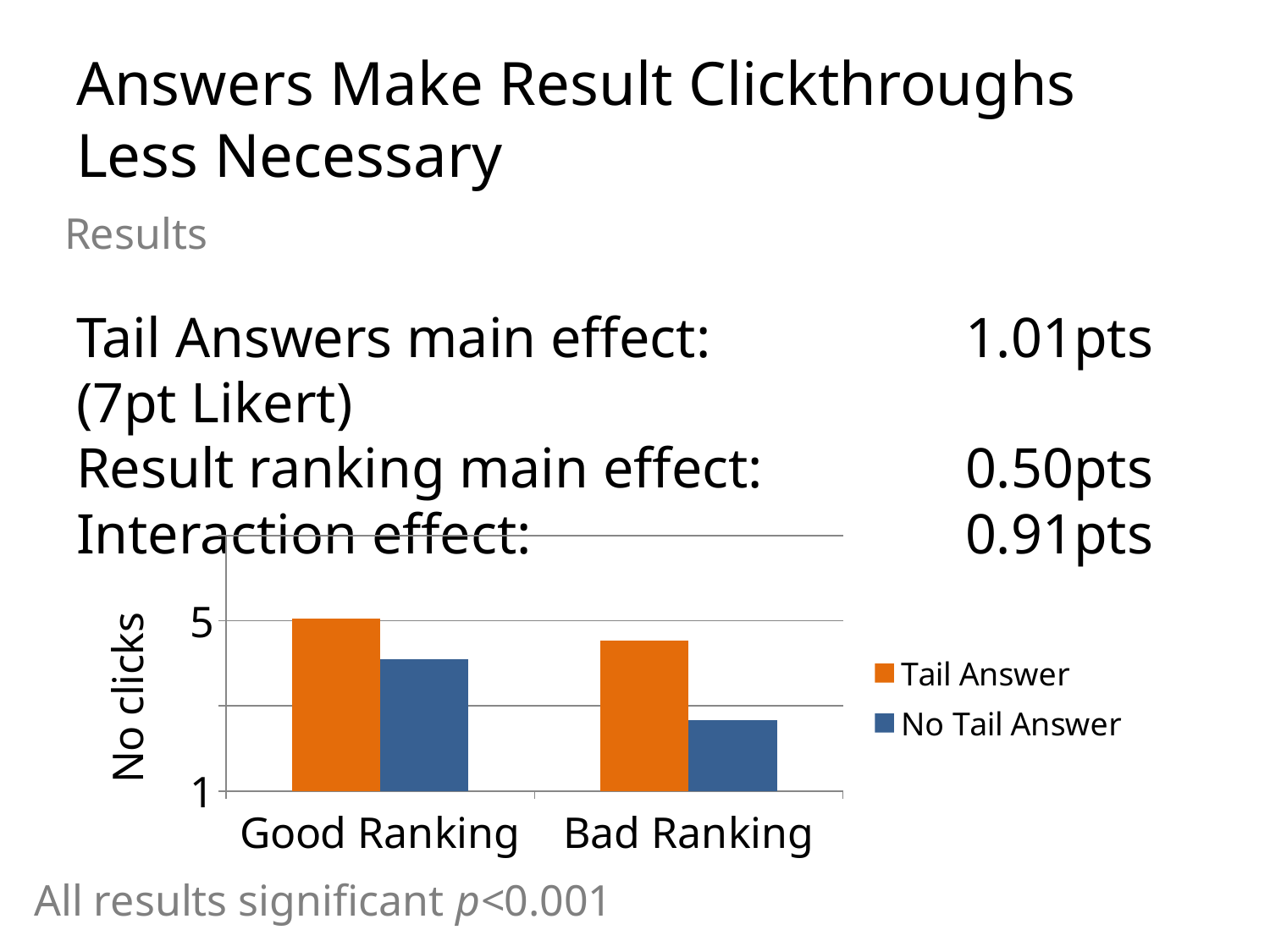
Is the value for Tail Answer under Bad Ranking greater or less than 5? less What kind of chart is shown on the slide? bar chart Is the value for No Tail Answer under Bad Ranking greater or less than 5? less Does the Tail Answer series rise or fall from Good Ranking to Bad Ranking? fall Which series has the taller bar for Bad Ranking, Tail Answer or No Tail Answer? Tail Answer What is the label on the chart's y axis? No clicks How many series does the chart's legend list? 2 What colour represents the Tail Answer series in the chart? orange Which bar in the chart is the highest? Tail Answer for Good Ranking How many categories are shown on the x axis of the chart? 2 Which series has the taller bar for Good Ranking, Tail Answer or No Tail Answer? Tail Answer Which bar in the chart is the lowest? No Tail Answer for Bad Ranking